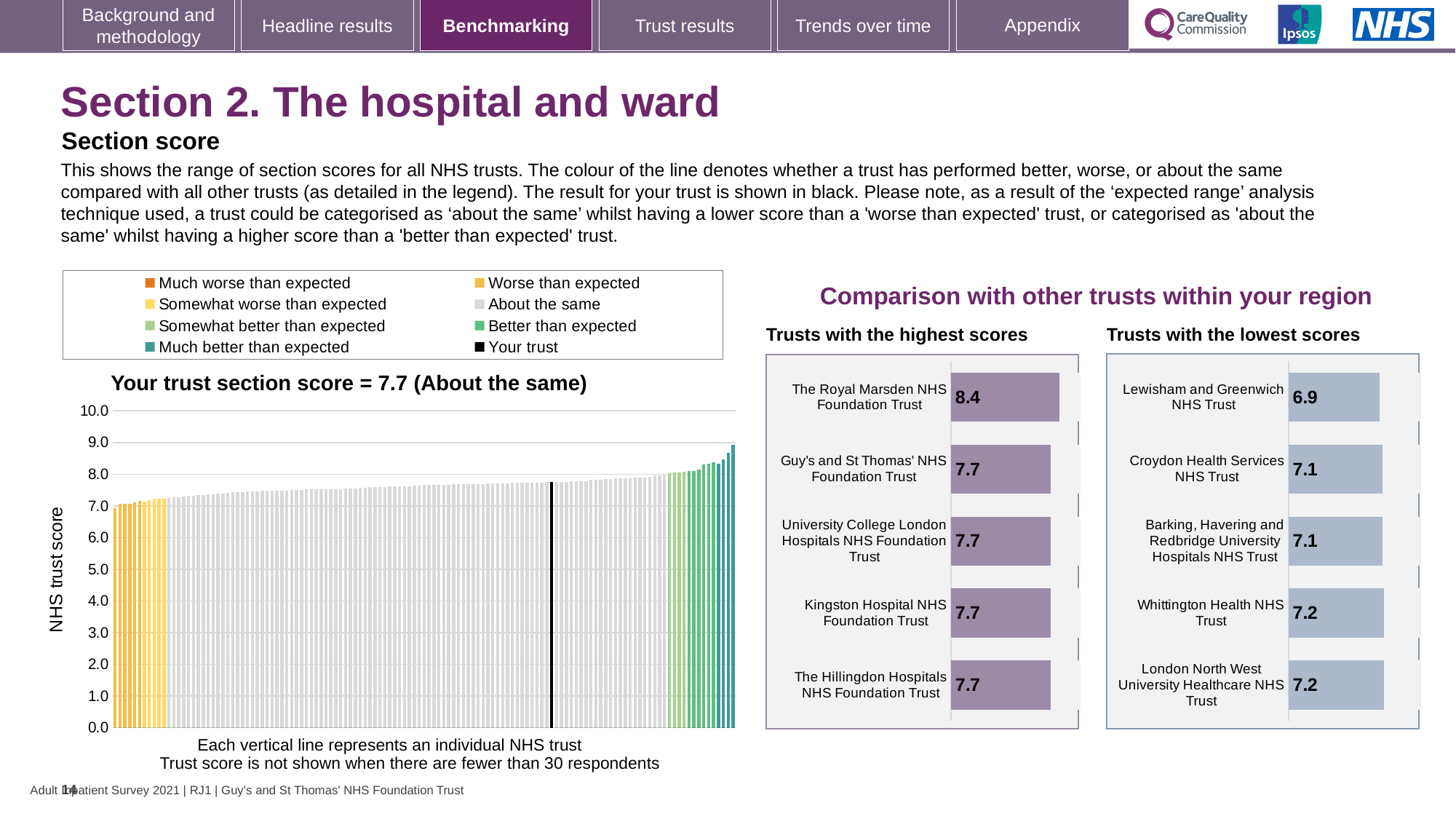
How many trusts are shown in the 'Trusts with the highest scores' chart? 5 In the 'Your trust section score' chart, do the trust scores rise or fall from left to right along the x axis? Rise In the 'Trusts with the lowest scores' chart, which trust has the lowest score? Lewisham and Greenwich NHS Trust In the 'Trusts with the highest scores' chart, what is the score for The Royal Marsden NHS Foundation Trust? 8.4 According to the title of the 'Your trust section score' chart, what is your trust's section score? 7.7 (About the same) In the 'Trusts with the highest scores' chart, which trust has the highest score? The Royal Marsden NHS Foundation Trust In the 'Trusts with the lowest scores' chart, which has the larger score: Croydon Health Services NHS Trust or Whittington Health NHS Trust? Whittington Health NHS Trust In the 'Trusts with the lowest scores' chart, what is the score for Lewisham and Greenwich NHS Trust? 6.9 In the 'Trusts with the highest scores' chart, what is the difference between the score for The Royal Marsden NHS Foundation Trust and the score for Kingston Hospital NHS Foundation Trust? 0.7 In the 'Trusts with the lowest scores' chart, what is the difference between the score for Whittington Health NHS Trust and the score for Lewisham and Greenwich NHS Trust? 0.3 How many entries does the legend of the 'Your trust section score' chart list? 8 What kind of chart is the 'Your trust section score' chart? Bar chart